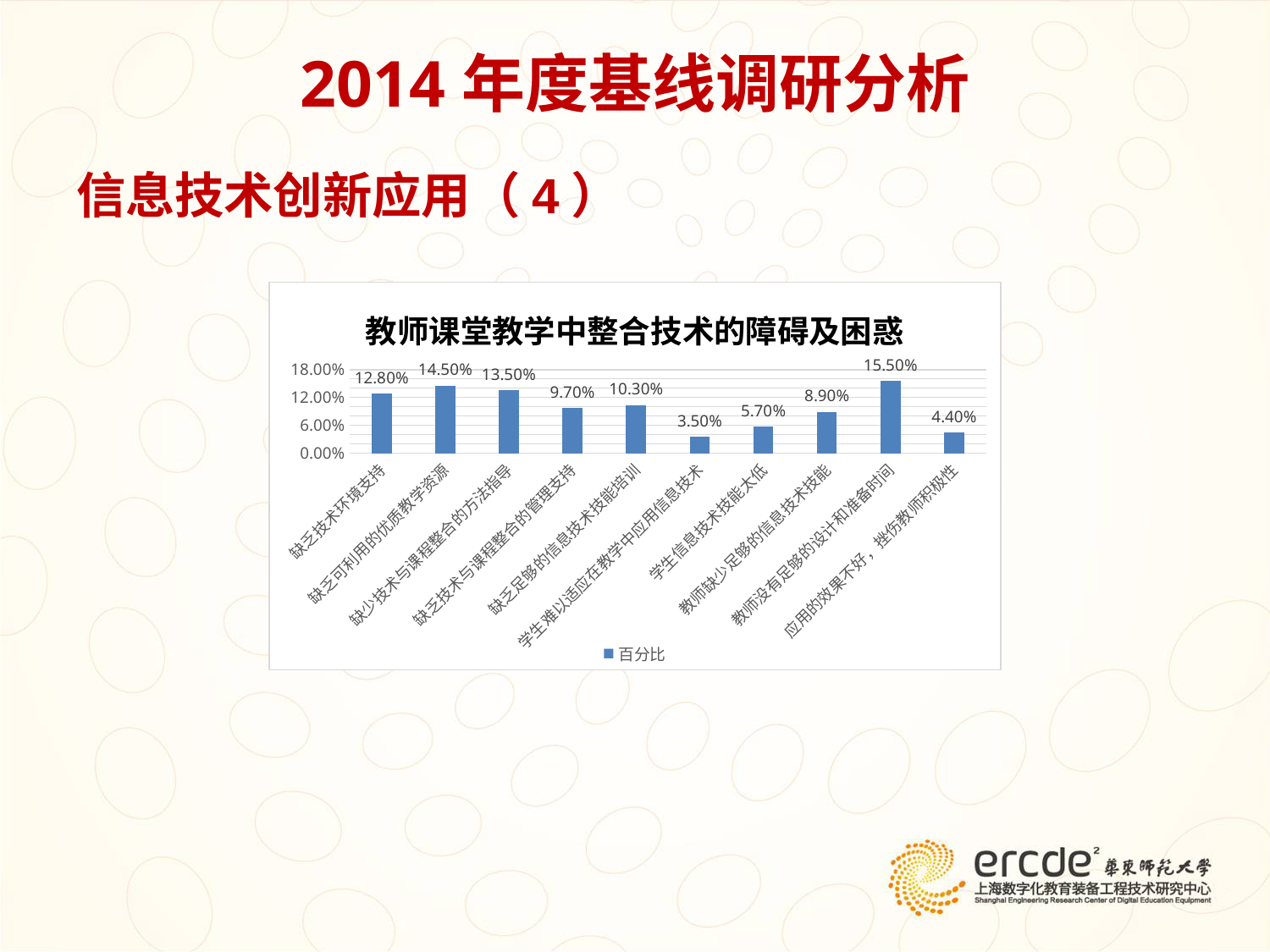
What is the difference between the values for 缺乏可利用的优质教学资源 and 缺少技术与课程整合的方法指导? 1.00% Is the value for 教师缺少足够的信息技术技能 greater or less than 12.00%? less What is the value for 教师没有足够的设计和准备时间? 15.50% Which category has the lowest value? 学生难以适应在教学中应用信息技术 Which is larger, the value for 缺乏足够的信息技术技能培训 or the value for 缺乏技术与课程整合的管理支持? 缺乏足够的信息技术技能培训 What kind of chart is shown? bar chart Which category has the highest value? 教师没有足够的设计和准备时间 How many categories are shown on the x axis? 10 What is the value for 缺乏技术环境支持? 12.80% How many series does the legend list? 1 What is the value for 学生信息技术技能太低? 5.70% What is the title of the chart? 教师课堂教学中整合技术的障碍及困惑